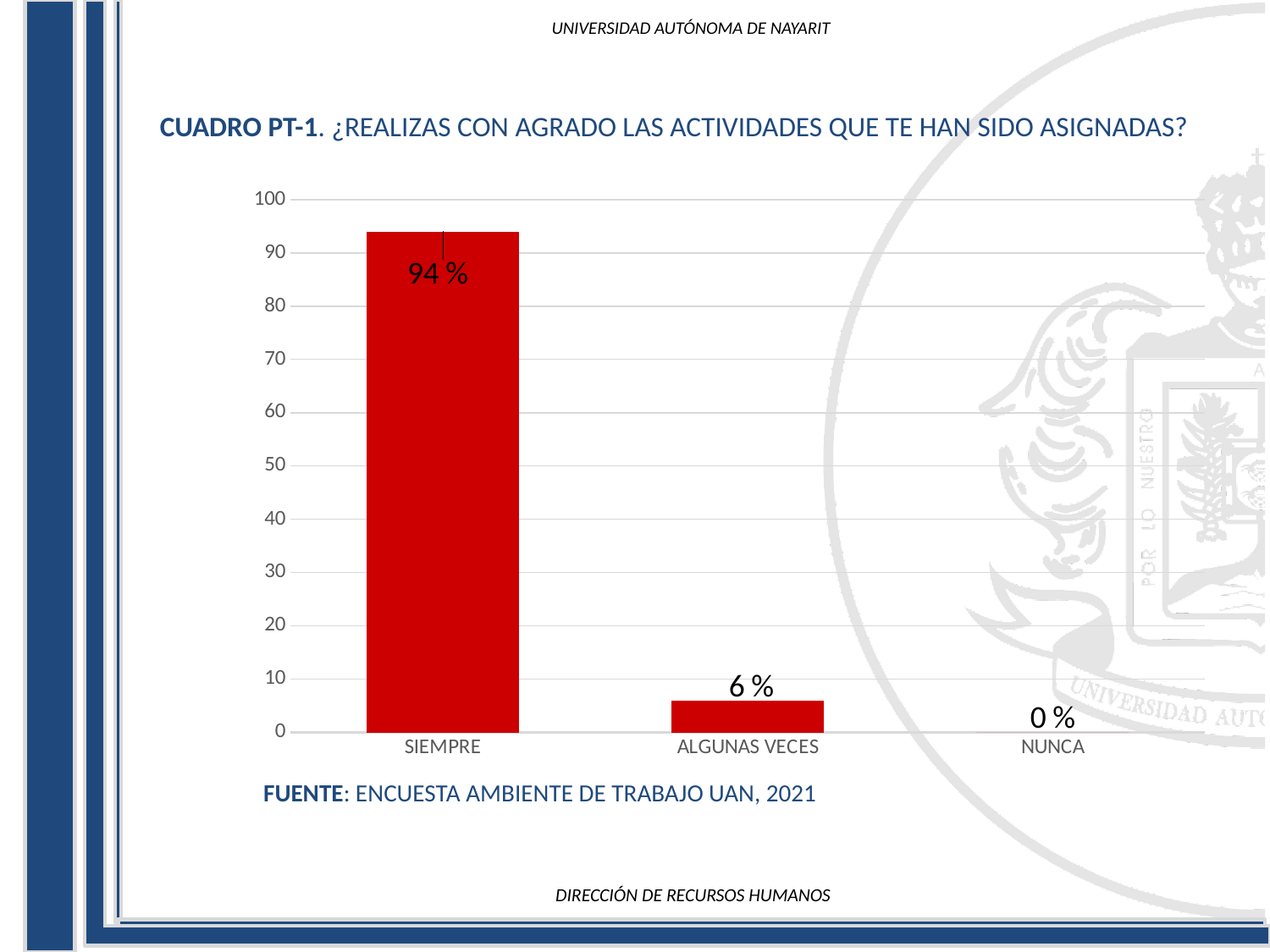
What colour are the bars in the chart? red What is the difference between the values for SIEMPRE and ALGUNAS VECES? 88 % Which is larger, the value for ALGUNAS VECES or the value for NUNCA? ALGUNAS VECES Which category has the highest value? SIEMPRE What is the value for ALGUNAS VECES? 6 % What kind of chart is shown on the slide? bar chart What is the value for NUNCA? 0 % Which category has the lowest value? NUNCA Is the value for SIEMPRE greater or less than 90? greater What is the value for SIEMPRE? 94 % How many categories are shown on the x axis? 3 Is the value for ALGUNAS VECES greater or less than 10? less